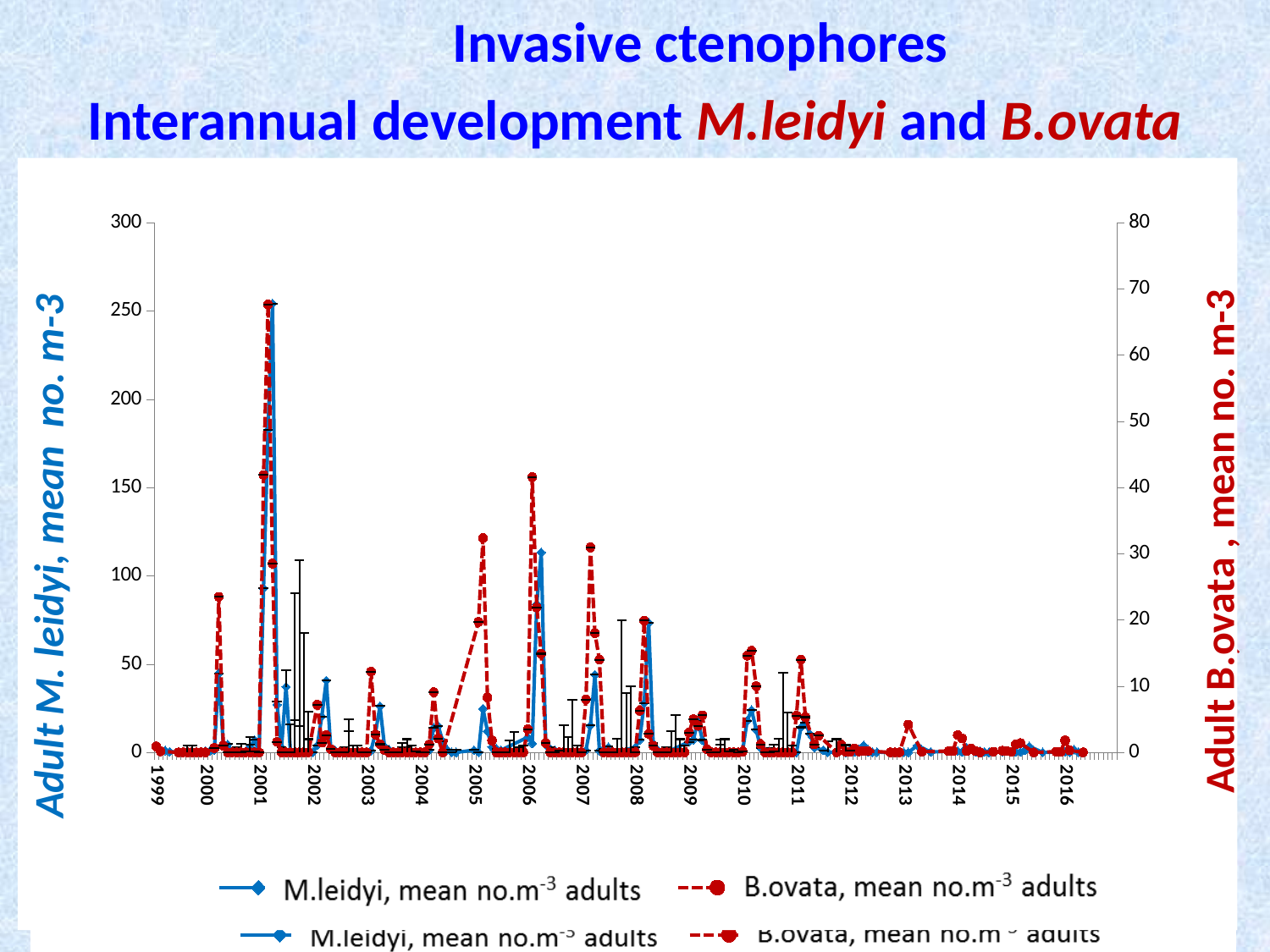
Do the peak values of both series generally rise or fall from 2011 to 2016? fall In which year does the M.leidyi series reach its highest peak? 2001 Is the peak value for M.leidyi in 2006 greater or less than 100 on the left axis? greater How many series does the chart legend list? 2 Is the peak value for B.ovata in 2001 greater or less than 60 on the right axis? greater Is the peak value for M.leidyi in 2001 greater or less than 200 on the left axis? greater What kind of chart is shown on the slide? line chart What is the highest tick value shown on the right-hand y axis? 80 How many year labels are shown on the x axis? 18 In which year does the B.ovata series reach its highest peak? 2001